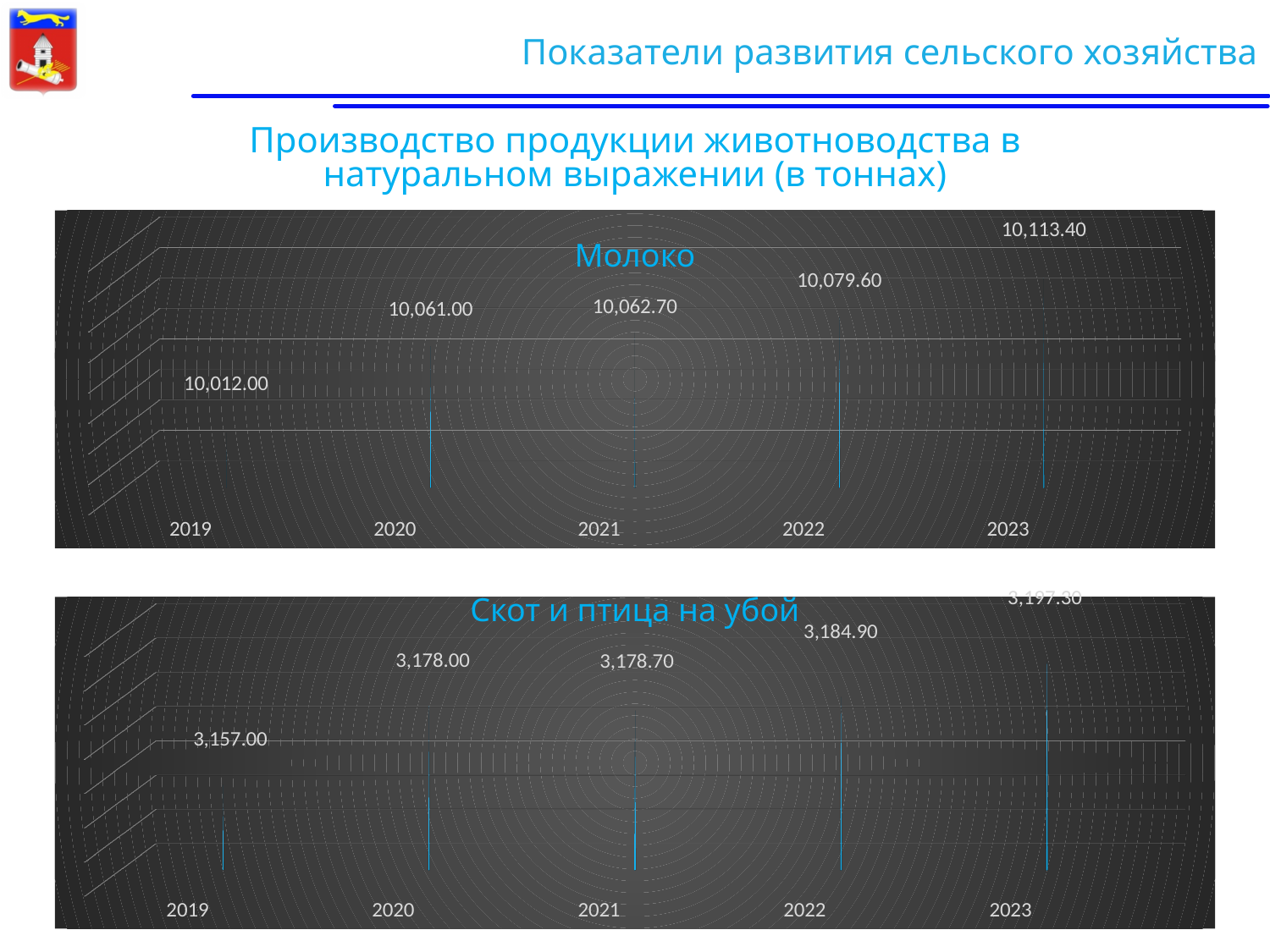
In the Молоко chart, which year has the highest value? 2023 In the Скот и птица на убой chart, what is the value for 2022? 3,184.90 In the Молоко chart, which year has the lowest value? 2019 In the Скот и птица на убой chart, what is the value for 2020? 3,178.00 In the Молоко chart, how many years are shown on the x axis? 5 In the Молоко chart, what is the value for 2019? 10,012.00 In the Молоко chart, do the values rise or fall from 2019 to 2023? rise What is the title of the lower chart on the slide? Скот и птица на убой In the Скот и птица на убой chart, which year has the lowest value? 2019 In the Молоко chart, what is the difference between the 2023 value and the 2019 value? 101.40 In the Молоко chart, what is the value for 2023? 10,113.40 In the Скот и птица на убой chart, what is the difference between the 2022 value and the 2019 value? 27.90